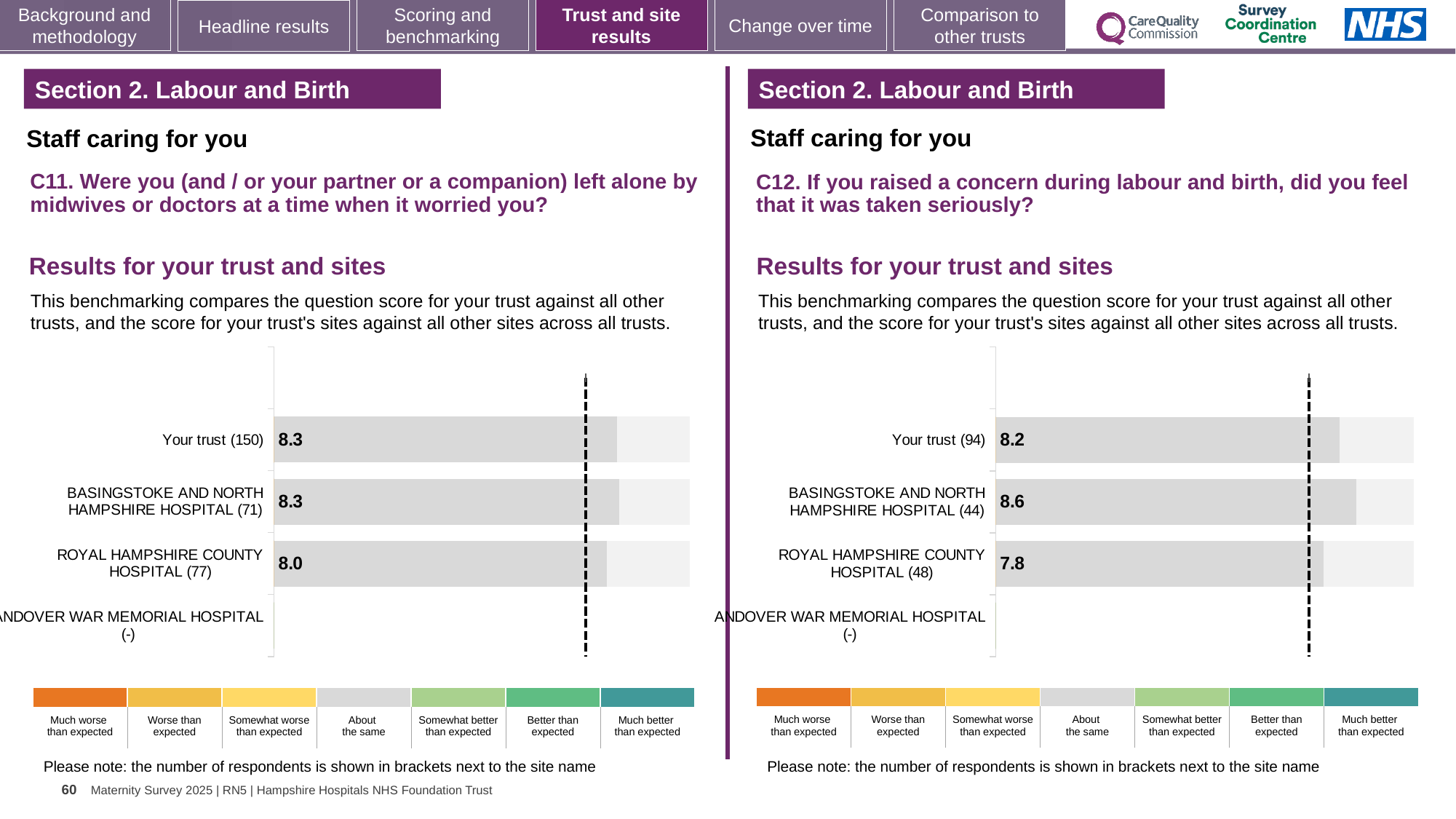
In the C12 chart on the right, which site has the lowest printed score? Royal Hampshire County Hospital In the C12 chart on the right, what is the score for Royal Hampshire County Hospital? 7.8 What type of chart is used in the C11 chart on the left? Bar chart In the C11 chart on the left, what is the difference between the score for Your trust and the score for Royal Hampshire County Hospital? 0.3 How many site/trust categories are listed on the y axis of the C12 chart on the right? 4 In the C12 chart on the right, what is the score for Basingstoke and North Hampshire Hospital? 8.6 In the C12 chart on the right, which site has the highest score? Basingstoke and North Hampshire Hospital In the C11 chart on the left, what is the score for Royal Hampshire County Hospital? 8.0 In the C11 chart on the left, what is the score for Your trust? 8.3 How many respondents are shown in brackets for Your trust in the C11 chart on the left? 150 In the C12 chart on the right, which is larger: the score for Your trust or the score for Basingstoke and North Hampshire Hospital? Basingstoke and North Hampshire Hospital In the C12 chart on the right, what is the difference between the scores for Basingstoke and North Hampshire Hospital and Royal Hampshire County Hospital? 0.8